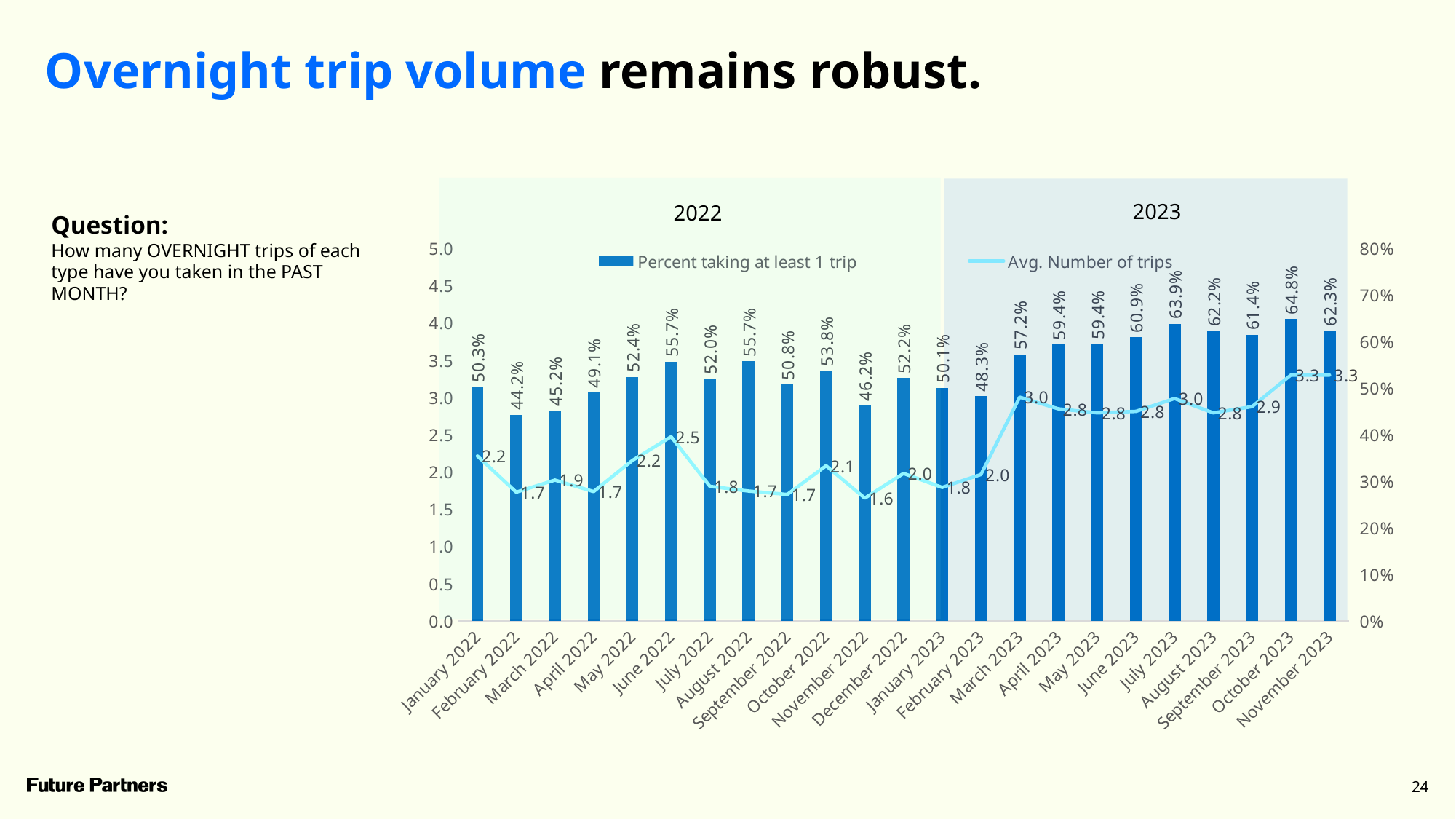
What percent of respondents took at least 1 overnight trip in October 2023? 64.8% What percent of respondents took at least 1 overnight trip in February 2022? 44.2% Which month has the highest percent taking at least 1 trip? October 2023 What was the average number of overnight trips in June 2022? 2.5 How many series does the legend list? 2 How many months are shown on the x axis? 23 Which month has a higher percent taking at least 1 trip, March 2023 or March 2022? March 2023 Which month has the lowest percent taking at least 1 trip? February 2022 What is the difference in percent taking at least 1 trip between July 2023 and July 2022? 11.9 percentage points What kind of chart is used to show the percent taking at least 1 trip? Bar chart Does the average number of trips generally rise or fall from February 2023 to November 2023? Rise Which month has the lowest average number of trips? November 2022